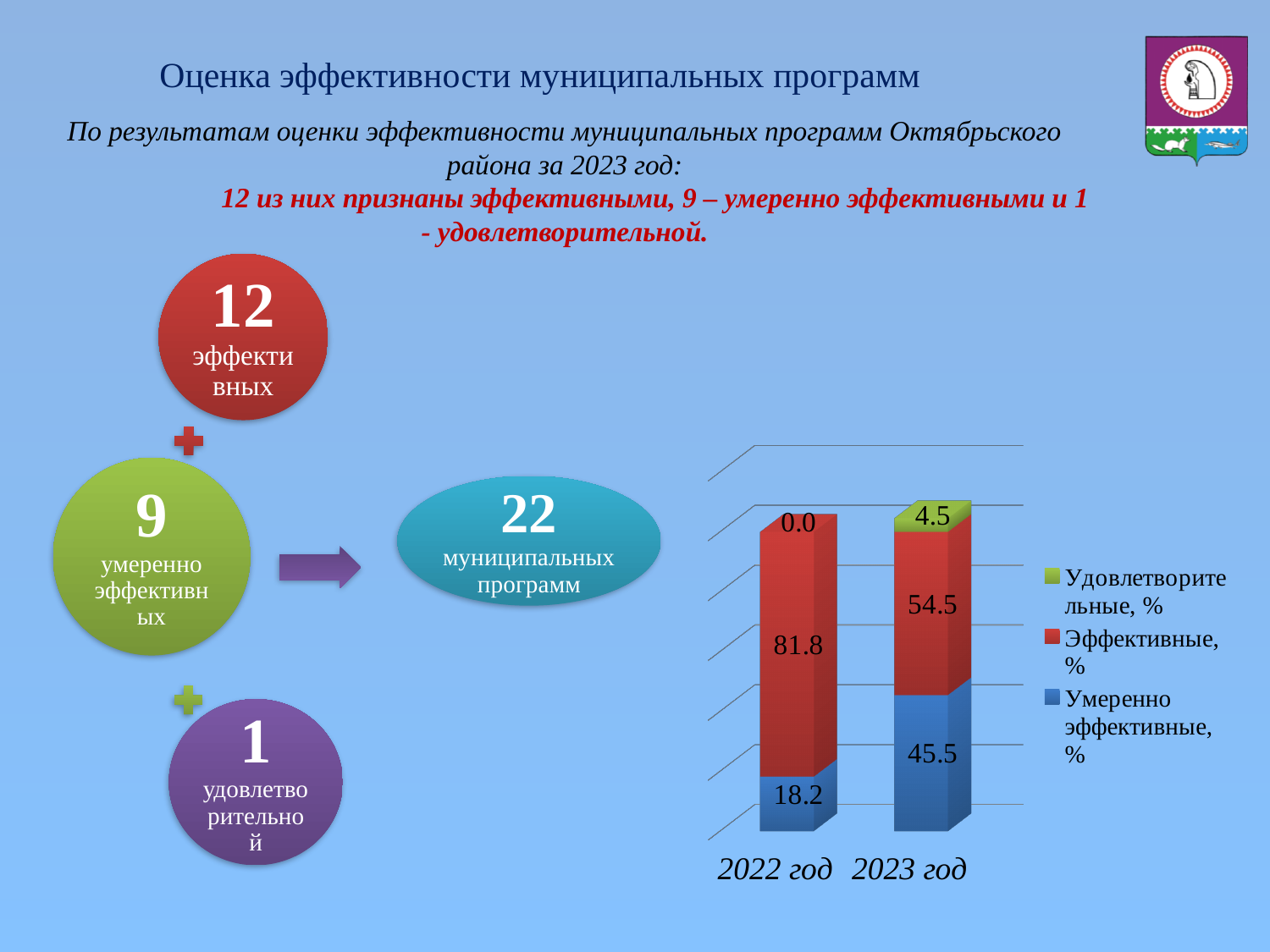
Which year has the larger value for Умеренно эффективные, %: 2022 год or 2023 год? 2023 год By how much did the Эффективные, % value decrease from 2022 год to 2023 год? 27.3 How many series does the chart legend list? 3 How many categories (years) are shown on the x axis of the chart? 2 What is the value of Удовлетворительные, % for 2023 год? 4.5 What is the value of Умеренно эффективные, % for 2022 год? 18.2 What is the value of Удовлетворительные, % for 2022 год? 0.0 Which colour represents the Эффективные, % series in the chart? red What is the value of Эффективные, % for 2022 год? 81.8 What is the total of the stacked bar for 2022 год? 100.0 What kind of chart is shown on the slide? stacked bar chart What is the value of Умеренно эффективные, % for 2023 год? 45.5